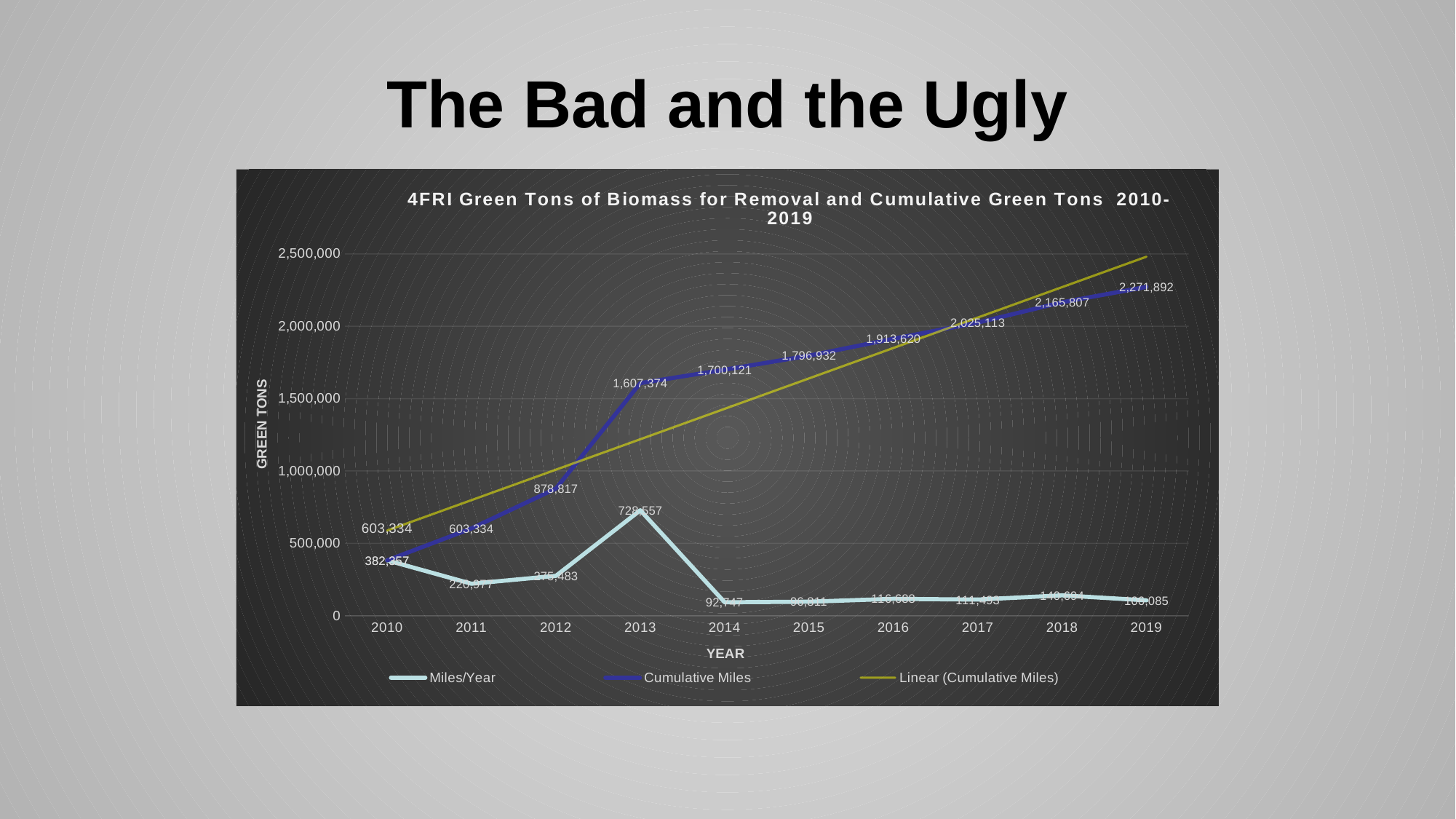
What is the difference between the Cumulative Miles values for 2019 and 2018? 106,085 In which year is the Miles/Year series highest? 2013 Which is larger, the Miles/Year value for 2010 or for 2012? 2010 Does the Cumulative Miles series rise or fall from 2010 to 2019? rise How many series does the legend list? 3 What is the Cumulative Miles value for 2013? 1,607,374 What is the Cumulative Miles value for 2019? 2,271,892 What kind of chart is shown on the slide? line chart What is the title of the vertical axis? GREEN TONS What is the Miles/Year value for 2013? 728,557 Is the Cumulative Miles value for 2016 greater or less than 2,000,000? less How many years are plotted along the x axis? 10